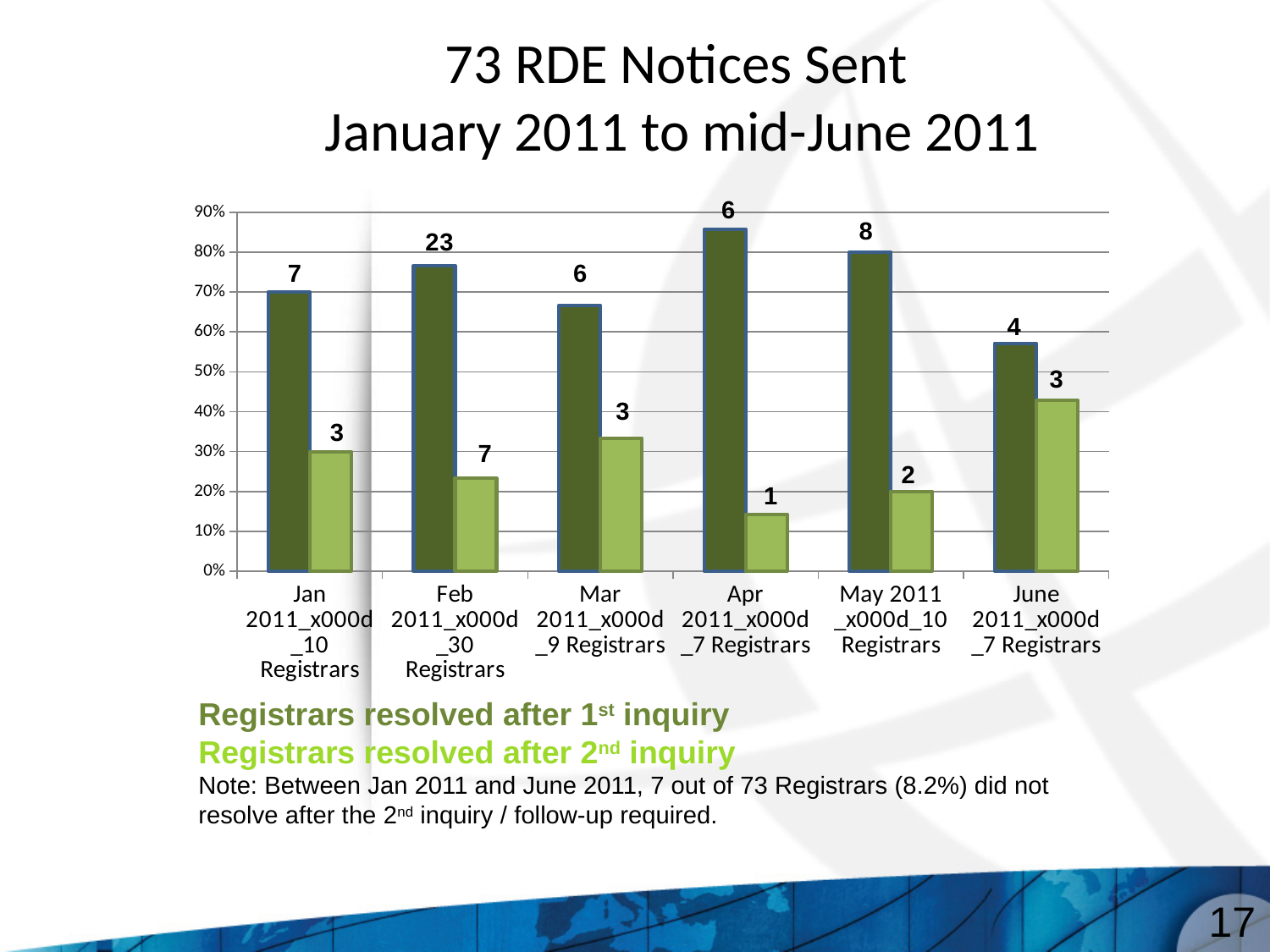
Which month has the taller dark green bar (resolved after 1st inquiry): Feb 2011 or Mar 2011? Feb 2011 Is the dark green bar (resolved after 1st inquiry) for Apr 2011 greater or less than 80%? greater Which month has the tallest dark green bar (resolved after 1st inquiry)? Apr 2011 What data label is shown on the dark green bar (resolved after 1st inquiry) for Feb 2011? 23 What does the dark green colour in the chart represent? Registrars resolved after 1st inquiry Which month has the shortest dark green bar (resolved after 1st inquiry)? June 2011 How many series does the chart's legend list? 2 What data label is shown on the dark green bar (resolved after 1st inquiry) for May 2011? 8 How many months (categories) are shown along the x axis of the chart? 6 What kind of chart is shown on the slide? bar chart What data label is shown on the light green bar (resolved after 2nd inquiry) for Apr 2011? 1 Is the light green bar (resolved after 2nd inquiry) for Jan 2011 greater or less than 40%? less